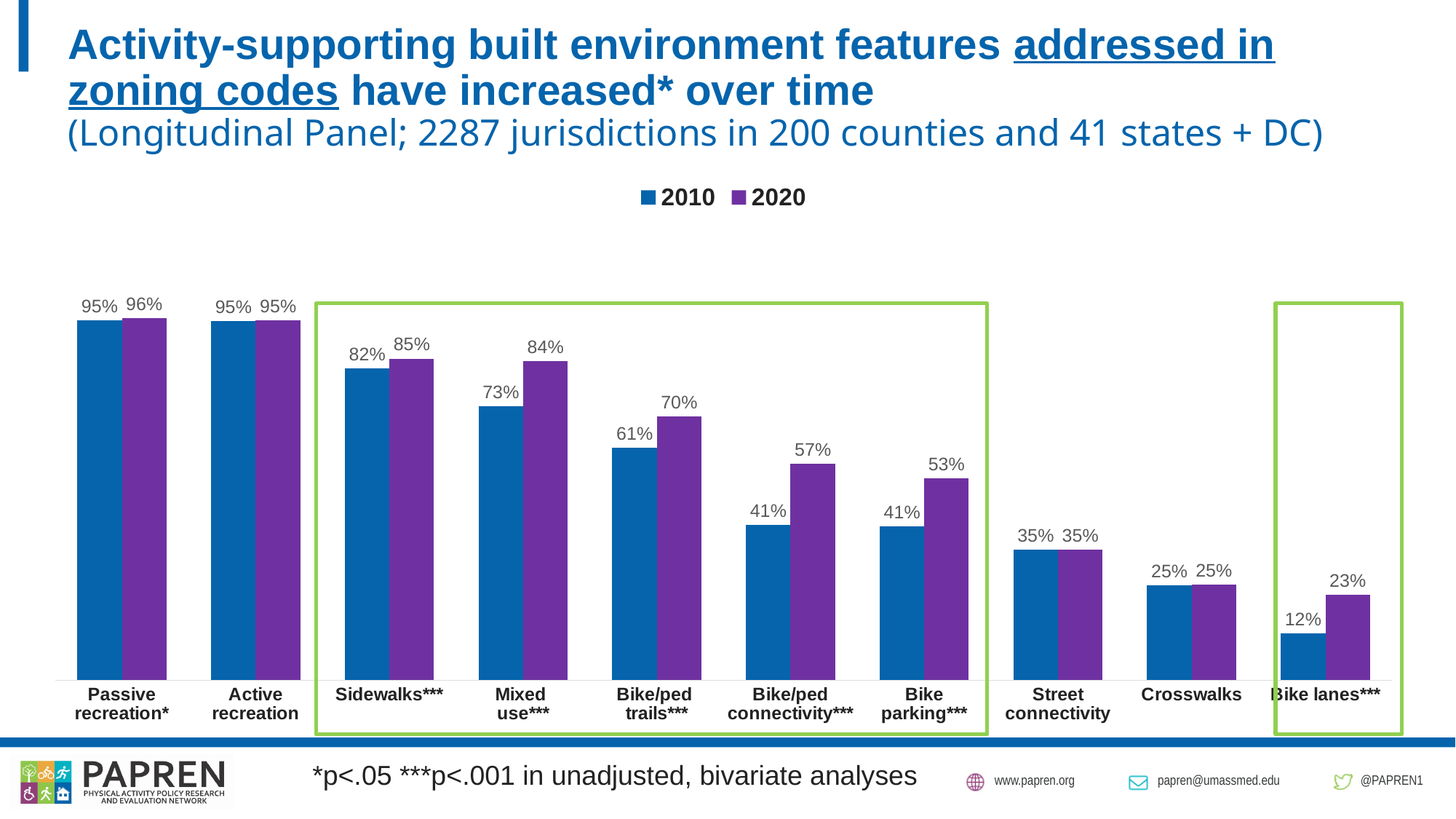
How many categories are shown on the x axis? 10 Which category has the highest 2020 value? Passive recreation* What is the 2010 value for Bike lanes***? 12% What is the difference between the 2020 and 2010 values for Bike parking***? 12% Which colour represents the 2020 series in the chart? Purple What is the 2010 value for Bike/ped trails***? 61% What is the difference between the 2020 and 2010 values for Bike/ped connectivity***? 16% What kind of chart is shown on the slide? Bar chart Which category has the lowest 2020 value? Bike lanes*** How many series does the legend list? 2 What is the 2020 value for Mixed use***? 84% Which is larger, the 2010 value for Sidewalks*** or the 2010 value for Mixed use***? Sidewalks***